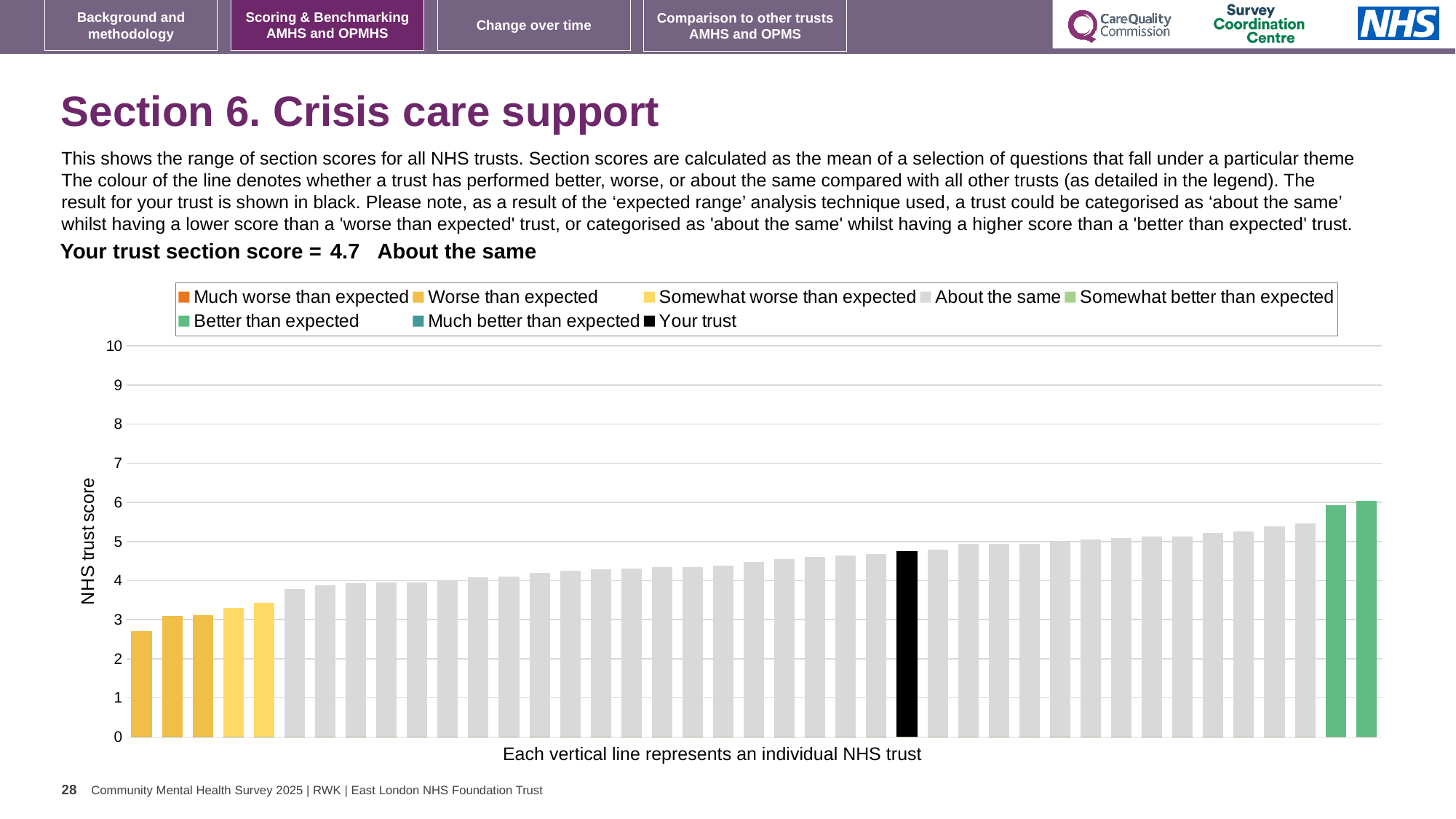
How many entries does the chart legend list? 8 Which legend category does the tallest bar belong to? Better than expected What kind of chart is shown on the slide? bar chart Do the bar values rise or fall from left to right along the x axis? rise Is the value of the tallest bar greater or less than 7? less What is the label on the y axis of the chart? NHS trust score Is the value of the tallest bar greater or less than 5? greater Which category is your trust placed in for this section? About the same Is the value of the leftmost bar greater or less than 3? less How many bars are coloured green ('Better than expected')? 2 What is the section score for your trust shown on the slide? 4.7